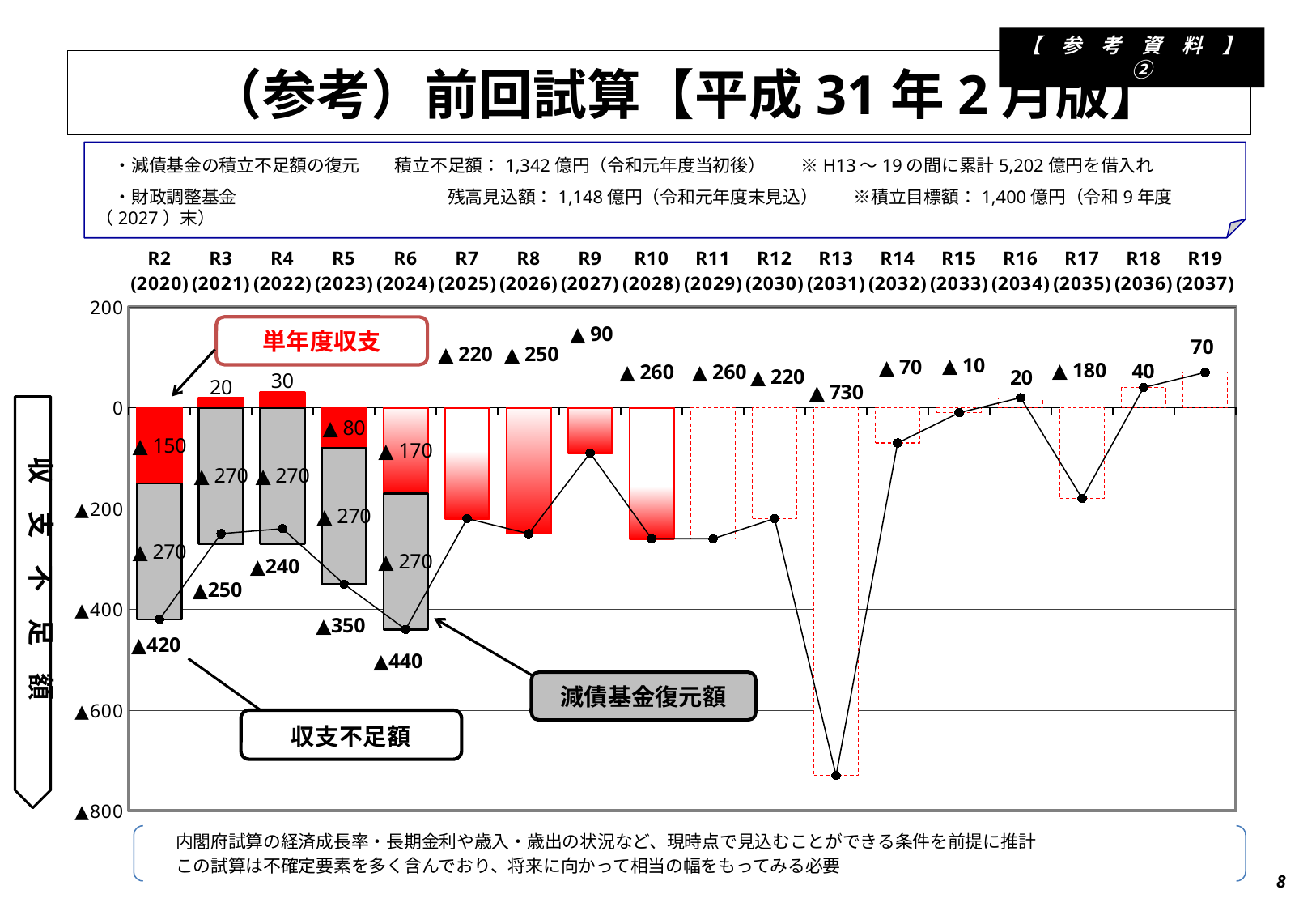
What is the 収支不足額 value plotted for R9 (2027)? ▲90 What is the difference between the 収支不足額 values for R19 (2037) and R18 (2036)? 30 How many fiscal years are shown along the x axis of the chart? 18 What is the 単年度収支 value shown for R2 (2020)? ▲150 Does the 収支不足額 line rise or fall from R14 (2032) to R16 (2034)? rise What is the 収支不足額 value plotted for R13 (2031)? ▲730 Which year shows the larger shortfall on the 収支不足額 line, R5 (2023) or R6 (2024)? R6 (2024) What kind of chart is shown on the slide? Combined bar and line chart Is the 収支不足額 point for R13 (2031) above or below the ▲600 gridline? below Which year has the lowest point on the 収支不足額 line? R13 (2031) Which year has the highest point on the 収支不足額 line? R19 (2037) What is the 減債基金復元額 value shown for R4 (2022)? ▲270